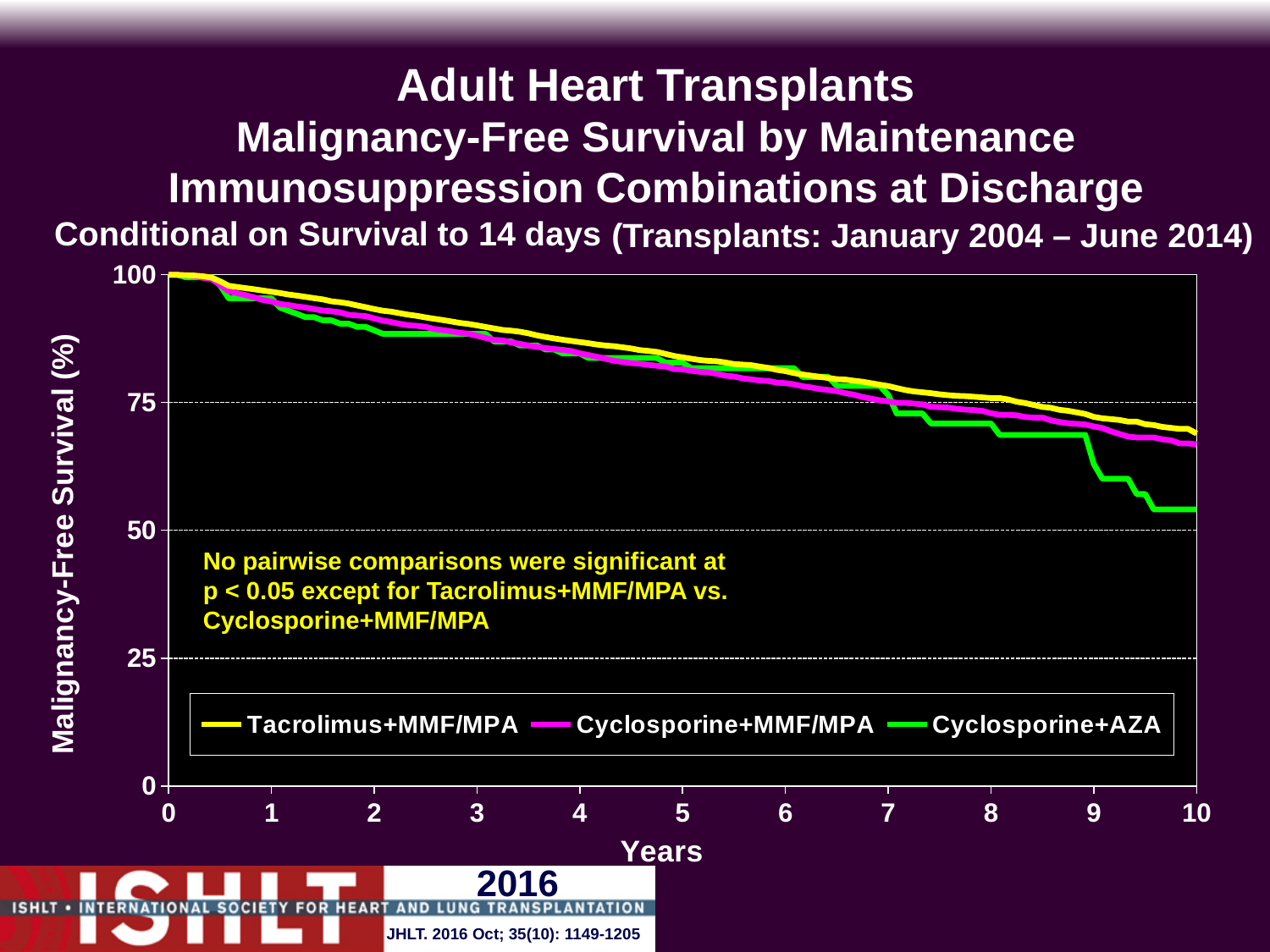
What is the malignancy-free survival (%) for all three series at year 0? 100 Do the malignancy-free survival curves rise or fall as years since transplant increase? fall How many series does the legend list? 3 At 3 years, is the malignancy-free survival for Cyclosporine+MMF/MPA greater or less than 75? greater At 10 years, which has higher malignancy-free survival: Tacrolimus+MMF/MPA or Cyclosporine+AZA? Tacrolimus+MMF/MPA At 10 years, which series has the lowest malignancy-free survival? Cyclosporine+AZA At 5 years, is the malignancy-free survival for Tacrolimus+MMF/MPA greater or less than 75? greater At 10 years, which series has the highest malignancy-free survival? Tacrolimus+MMF/MPA At 10 years, is the malignancy-free survival for Tacrolimus+MMF/MPA greater or less than 75? less Which series is drawn in green in the chart? Cyclosporine+AZA What kind of chart is shown on the slide? line chart